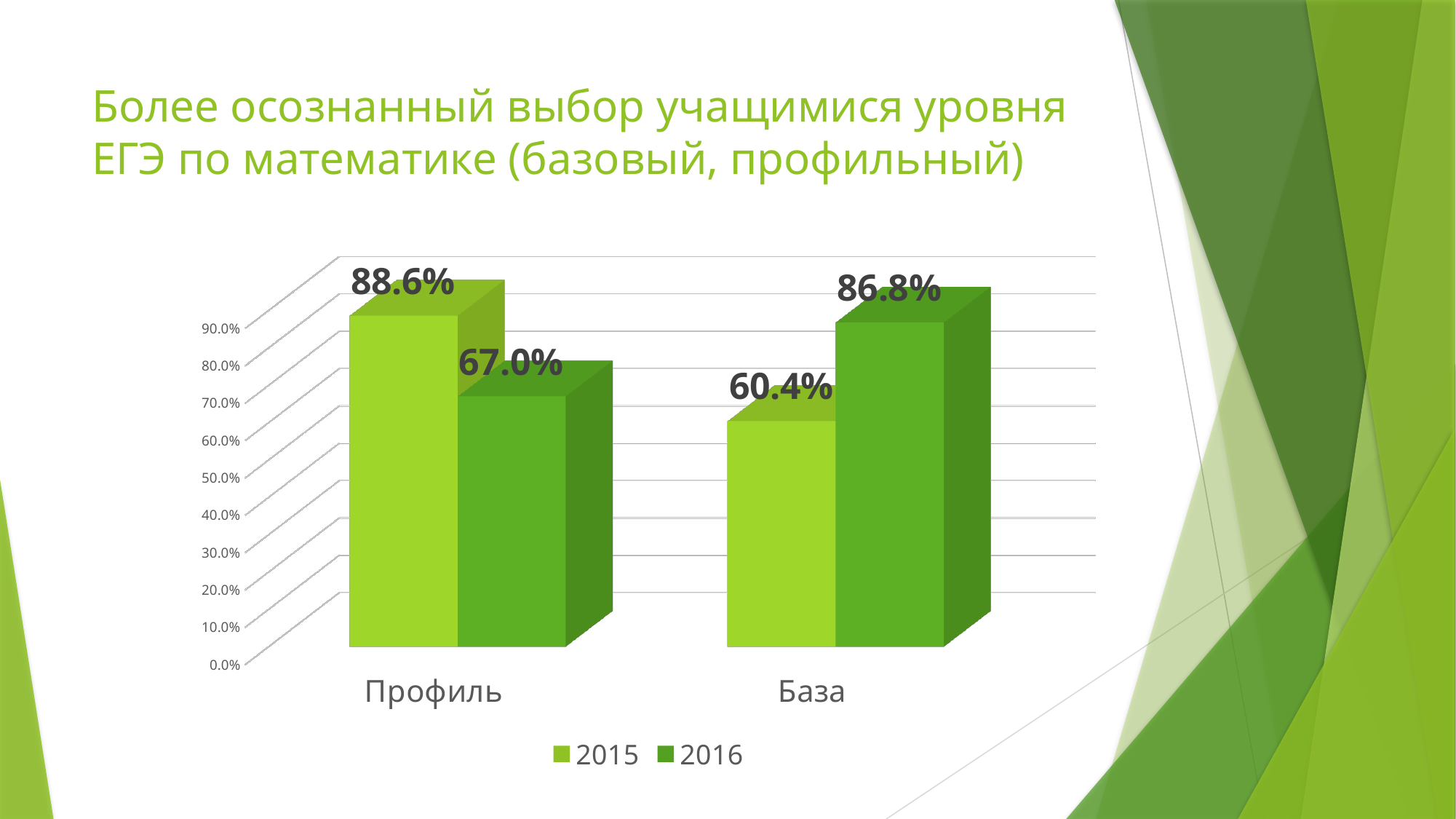
What is the value for База in 2016? 86.8% What is the value for База in 2015? 60.4% What is the value for Профиль in 2015? 88.6% What is the difference between the 2015 and 2016 values for Профиль? 21.6% How many categories are shown on the x axis? 2 Which category has the highest value in the 2015 series? Профиль What kind of chart is shown on the slide? Bar chart What is the difference between the 2016 and 2015 values for База? 26.4% Which category has the lowest value in the 2016 series? Профиль What is the value for Профиль in 2016? 67.0% Which is larger for База: the 2015 value or the 2016 value? 2016 How many series does the legend list? 2